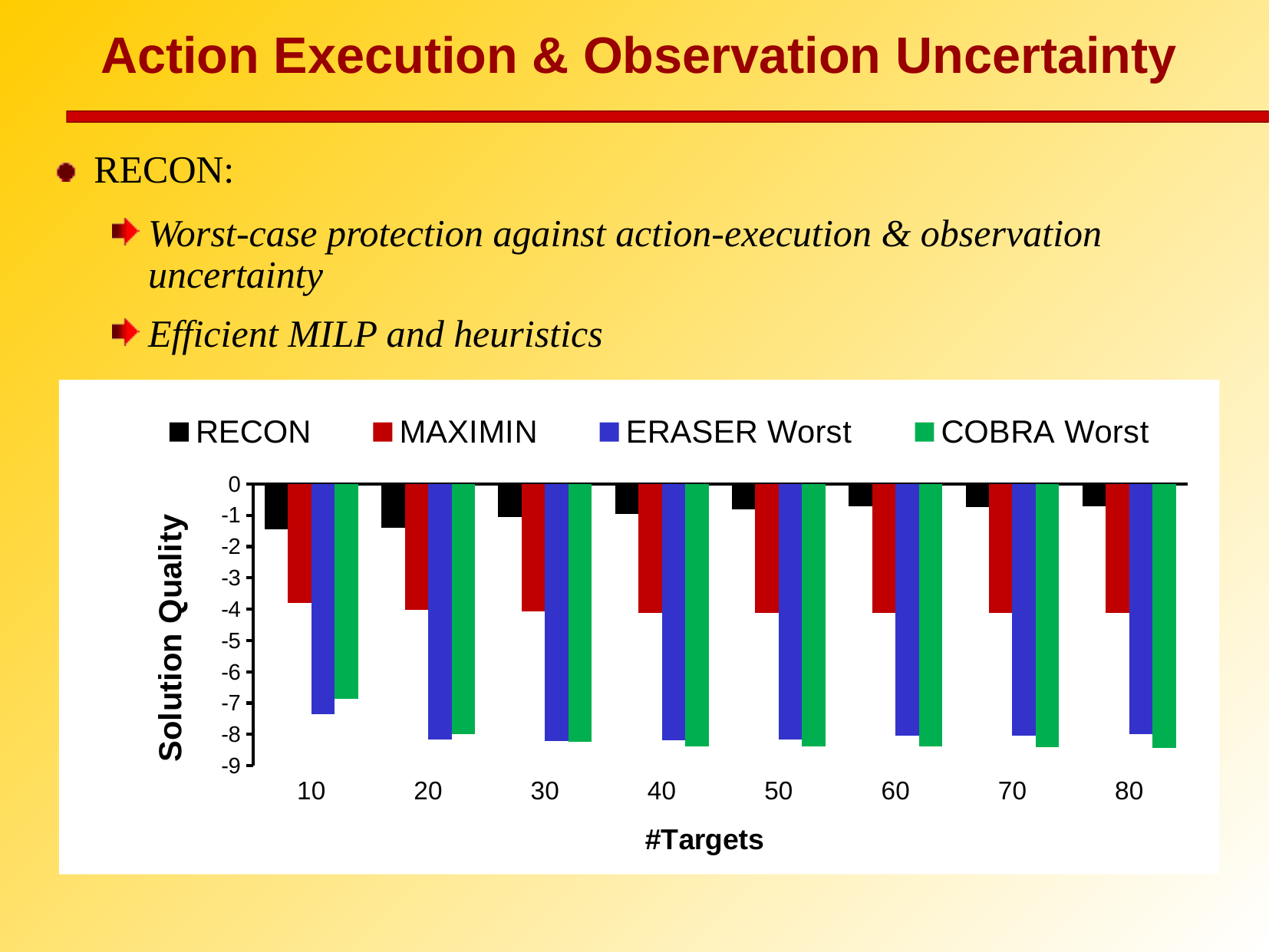
Is the COBRA Worst value at 10 targets greater or less than -6? less Do the RECON values rise or fall as the number of targets increases from 10 to 80? rise How many #Targets categories are shown on the x axis? 8 What kind of chart is shown on the slide? bar chart Which series has the highest solution quality at every number of targets? RECON How many series does the legend list? 4 Is the RECON value at 80 targets greater or less than -1? greater What is the title of the y axis? Solution Quality Is the RECON value at 10 targets greater or less than -1? less At 10 targets, which series has the higher solution quality, RECON or MAXIMIN? RECON